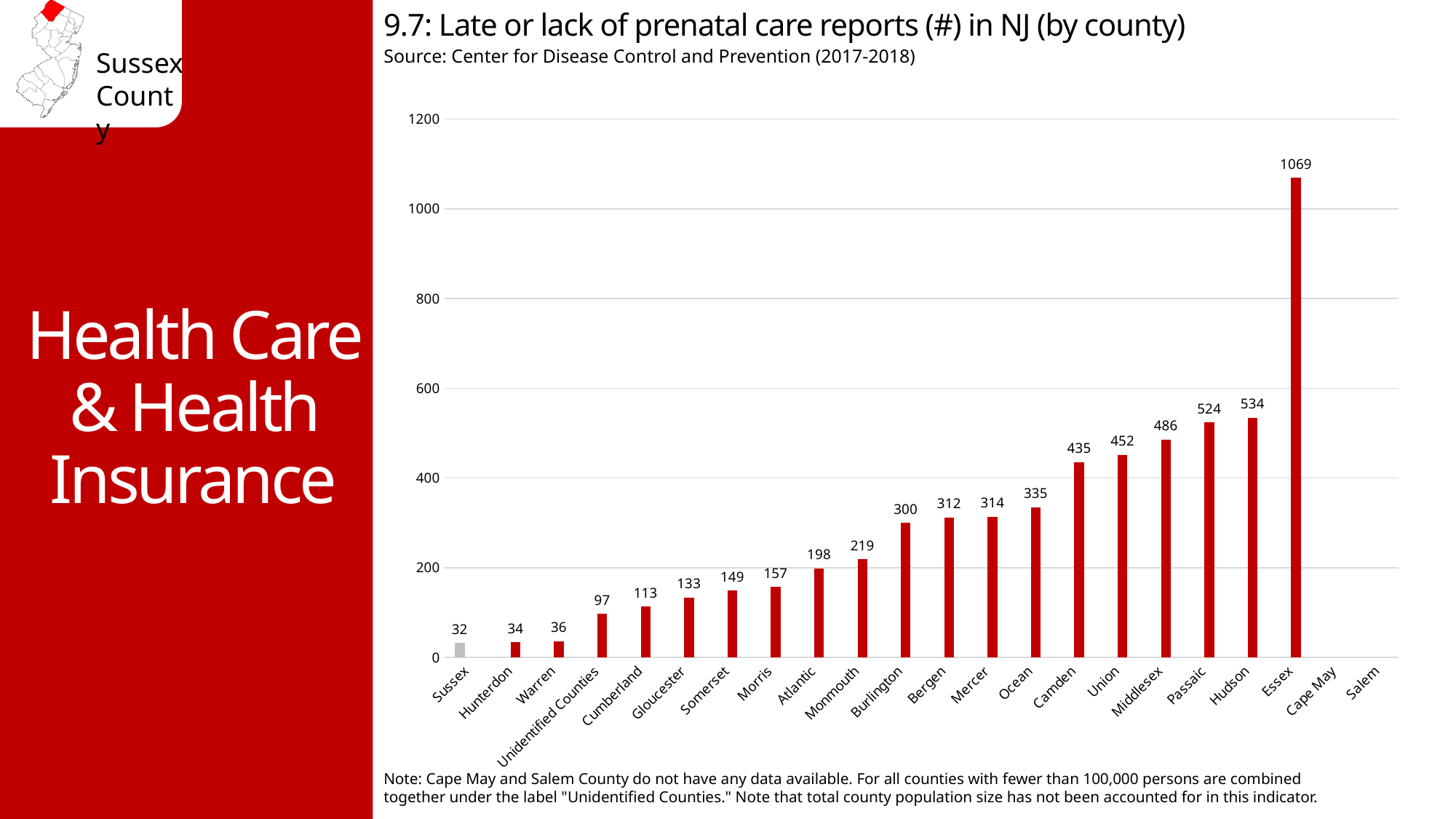
Which is larger, the value for Camden or the value for Ocean? Camden What kind of chart is shown on the slide? bar chart Which county has the highest number of late or lack of prenatal care reports? Essex Is the value for Union greater or less than 400? greater What is the difference between the values for Essex and Hudson? 535 What is the difference between the values for Hudson and Passaic? 10 What is the value shown for Essex? 1069 What is the source cited for the chart? Center for Disease Control and Prevention (2017-2018) What is the value shown for Middlesex? 486 Do the values generally rise or fall from Sussex to Essex along the x axis? rise Which county with a plotted value has the lowest number of reports? Sussex What is the number of late or lack of prenatal care reports for Sussex? 32